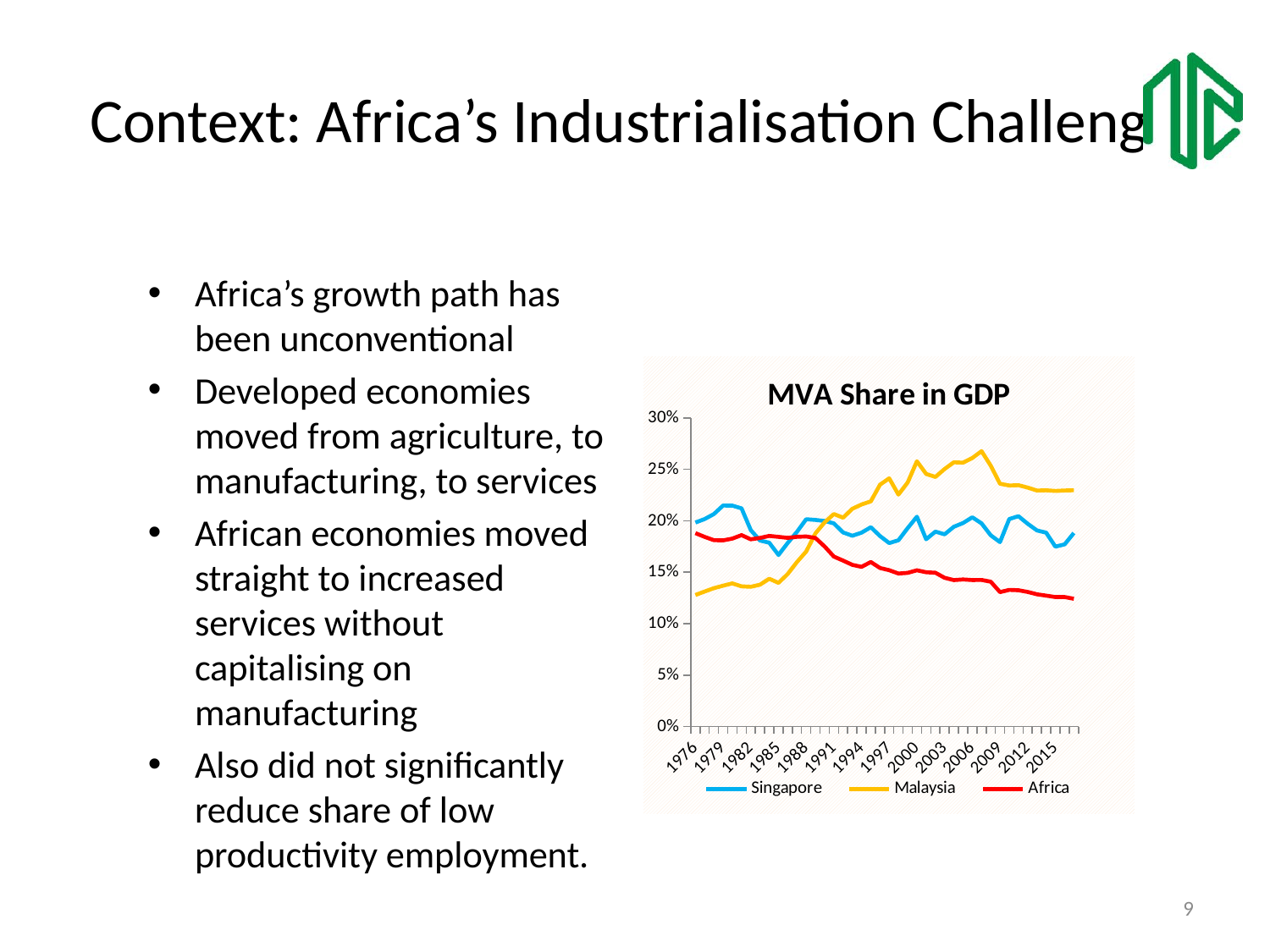
Is the value for Africa in 2015 greater or less than 15%? less Does the Africa line rise or fall overall from 1976 to 2015? fall What is the title of the chart? MVA Share in GDP How many series does the legend of the chart list? 3 Is the value for Malaysia in 1976 greater or less than 15%? less What kind of chart is shown on the slide? line chart Which series has the highest value at the end of the chart (2015)? Malaysia In 1976, which is larger: the value for Singapore or the value for Malaysia? Singapore Which series has the lowest value at the end of the chart (2015)? Africa Which series are listed in the chart's legend? Singapore, Malaysia, Africa Is the value for Malaysia in 2006 greater or less than 25%? greater Does the Malaysia line rise or fall overall from 1976 to 2015? rise